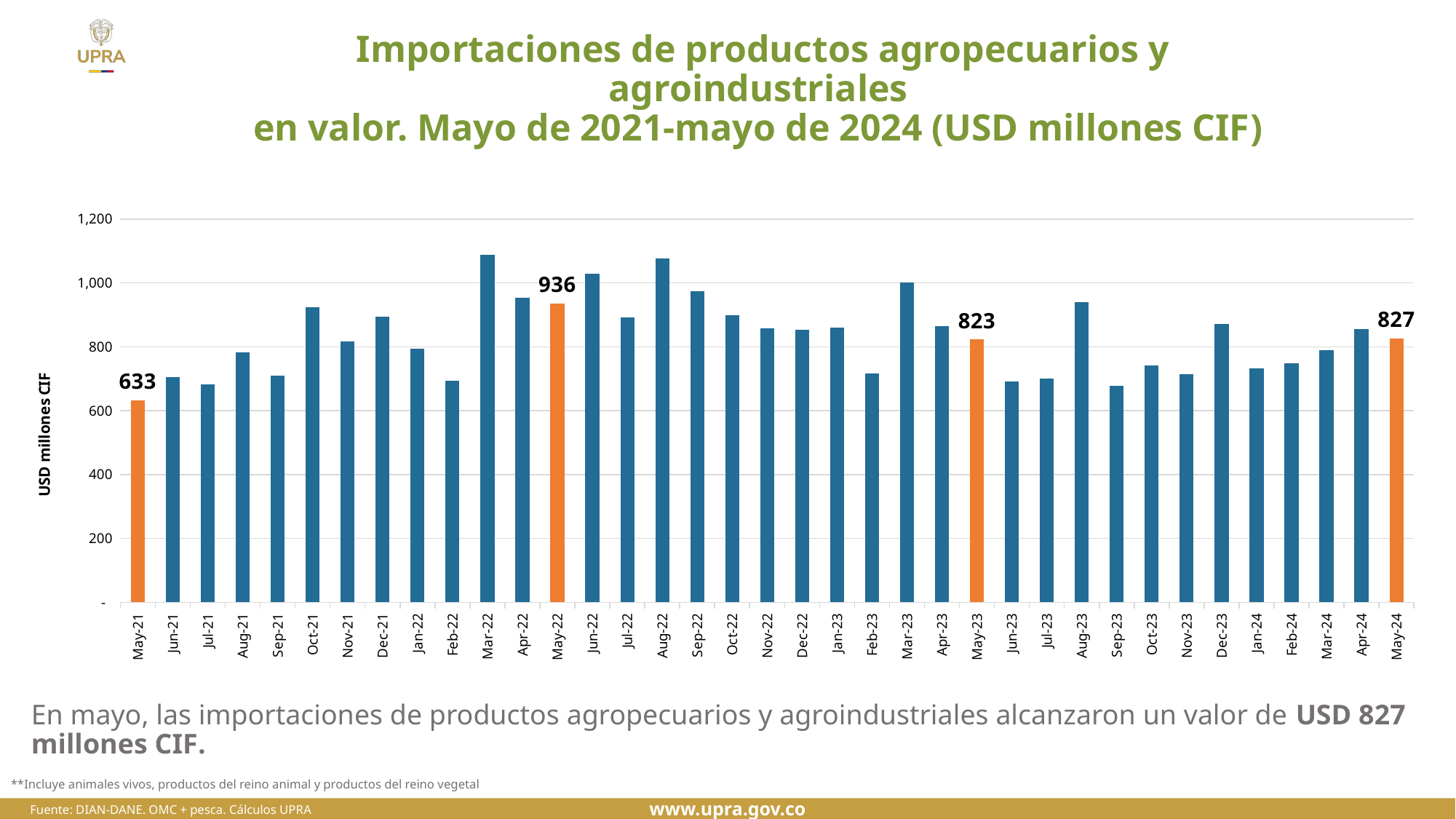
What is the value for May-21? 633 Which month has the lowest value in the chart? May-21 Which is larger, the value for May-22 or the value for May-23? May-22 Is the value for Feb-22 greater or less than 800? less Is the value for Mar-22 greater or less than 1,000? greater What is the value for May-24? 827 What kind of chart is shown on the slide? Bar chart What is the difference between the values for May-22 and May-23? 113 What is the difference between the values for May-24 and May-21? 194 What is the value for May-22? 936 What is the label of the vertical axis? USD millones CIF How many monthly bars are plotted in the chart? 37